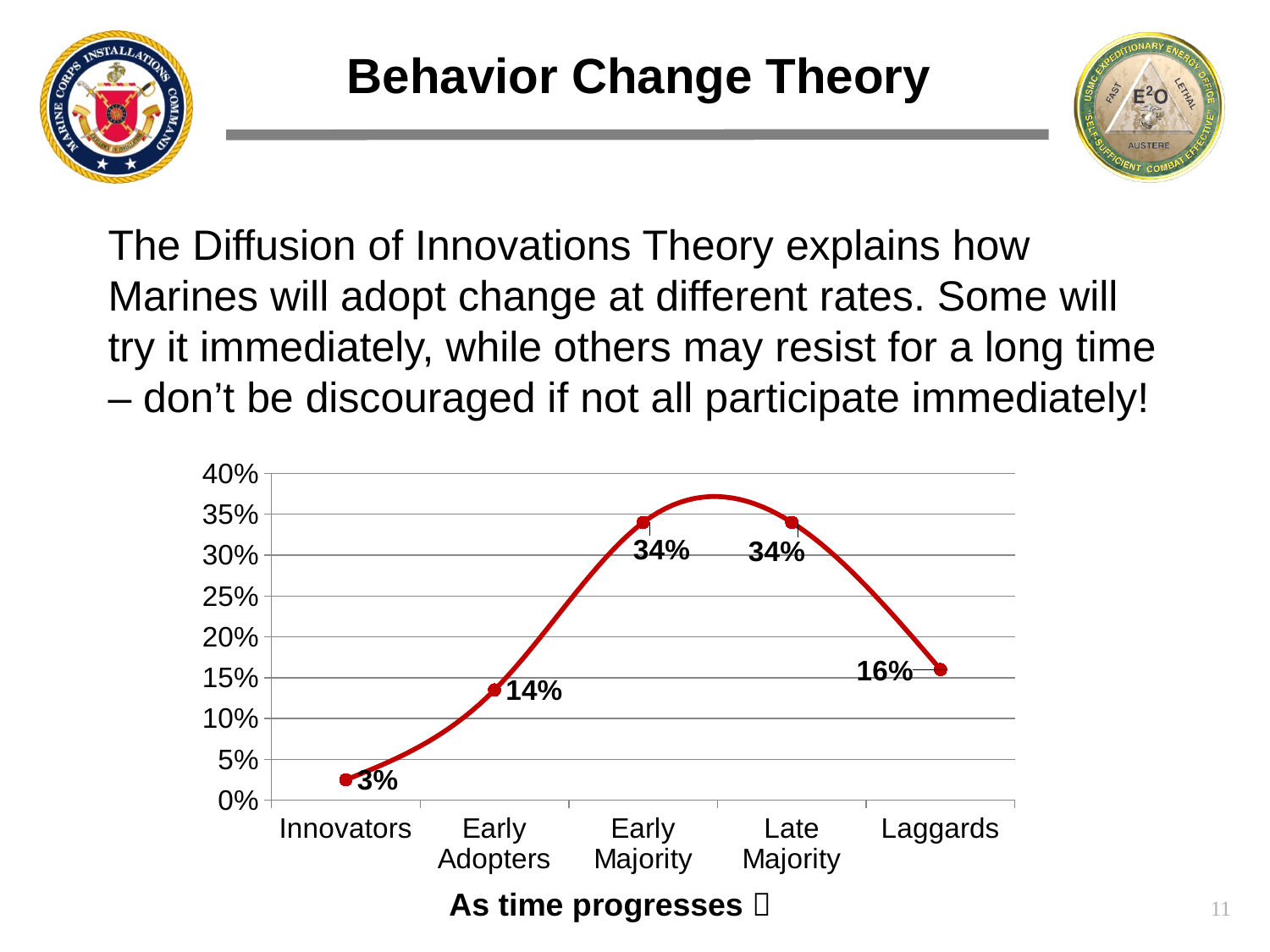
What kind of chart is shown on the slide? Line chart What is the value for Early Adopters? 14% How many categories are shown on the x axis? 5 What is the difference between the values for Early Majority and Early Adopters? 20% Which is larger, the value for Laggards or the value for Early Adopters? Laggards What is the value for Late Majority? 34% What is the value for Laggards? 16% Is the value for Early Majority greater or less than 30%? greater What is the difference between the values for Laggards and Innovators? 13% What is the value for Innovators? 3% What is the x-axis title of the chart? As time progresses Which category has the lowest value? Innovators